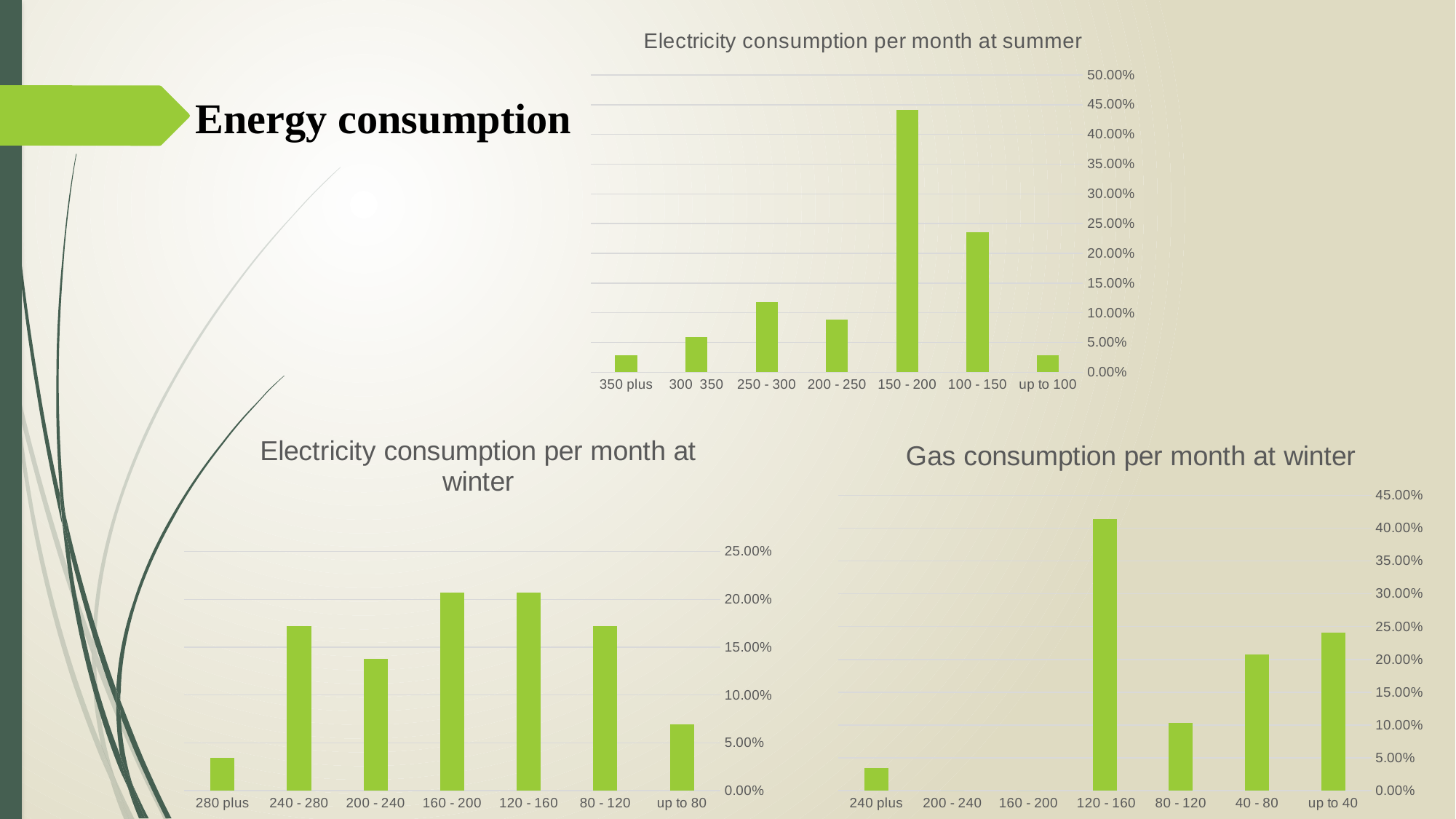
In the 'Electricity consumption per month at summer' chart, is the value for 100 - 150 greater or less than 20.00%? greater In the 'Gas consumption per month at winter' chart, which is larger, the value for 40 - 80 or the value for 80 - 120? 40 - 80 In the 'Electricity consumption per month at summer' chart, which category has the highest value? 150 - 200 In the 'Electricity consumption per month at summer' chart, which is larger, the value for 250 - 300 or the value for 200 - 250? 250 - 300 In the 'Gas consumption per month at winter' chart, is the value for up to 40 greater or less than 20.00%? greater What type of chart is 'Electricity consumption per month at summer'? bar chart In the 'Electricity consumption per month at winter' chart, which category has the lowest value? 280 plus In the 'Gas consumption per month at winter' chart, which category has the highest value? 120 - 160 In the 'Electricity consumption per month at winter' chart, is the value for up to 80 greater or less than 10.00%? less How many categories are shown in the 'Electricity consumption per month at summer' chart? 7